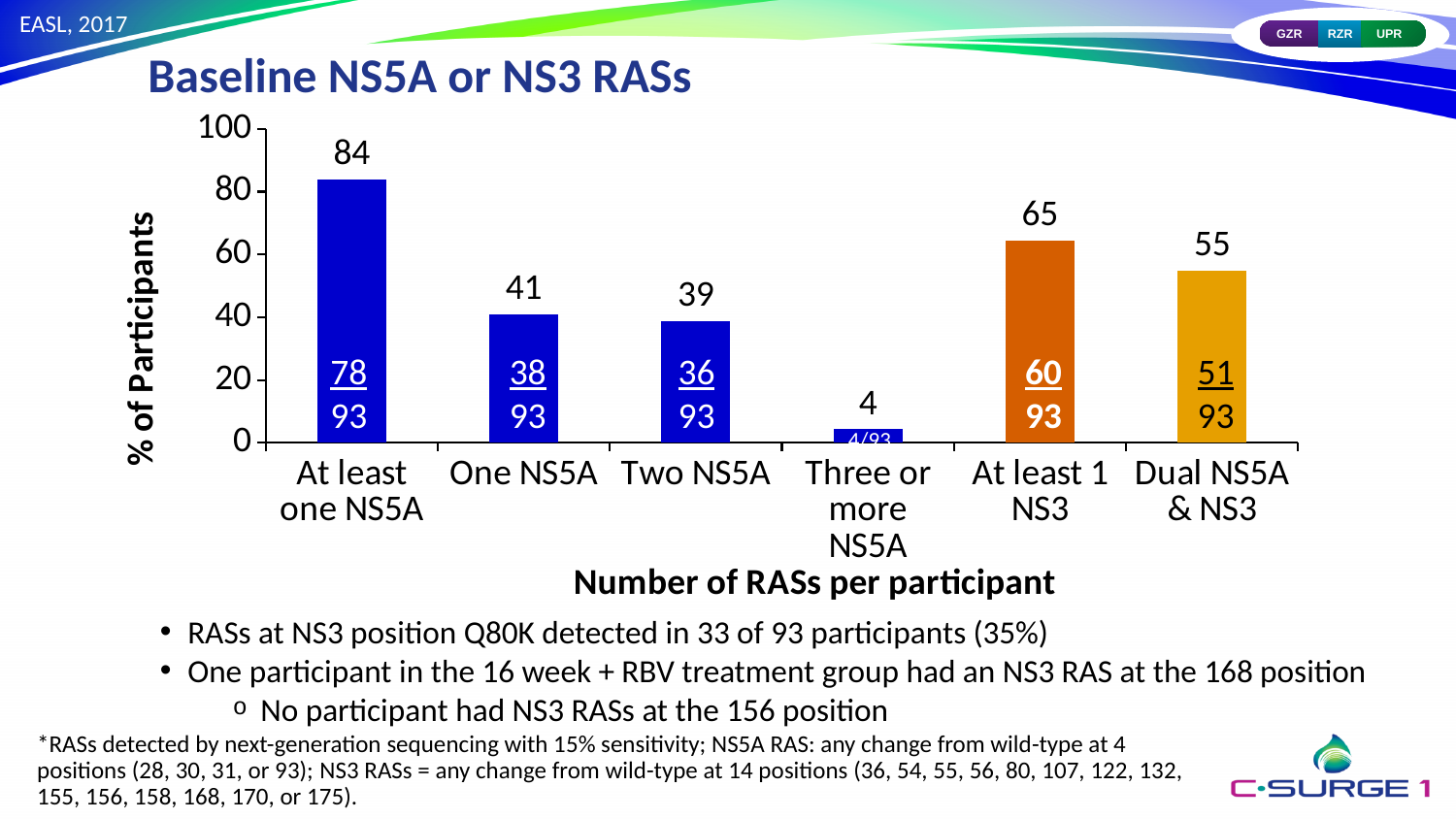
What is the value for "Dual NS5A & NS3"? 55 What kind of chart is shown on the slide? Bar chart What is the value for "Three or more NS5A"? 4 What is the value for "At least one NS5A"? 84 What is the difference between the values for "At least one NS5A" and "At least 1 NS3"? 19 Is the value for "Two NS5A" greater or less than 60? less What is the value for "At least 1 NS3"? 65 How many categories are shown on the x axis? 6 Which is larger, the value for "One NS5A" or the value for "Dual NS5A & NS3"? Dual NS5A & NS3 Which category has the highest value? At least one NS5A What is the title of the y axis? % of Participants Which category has the lowest value? Three or more NS5A